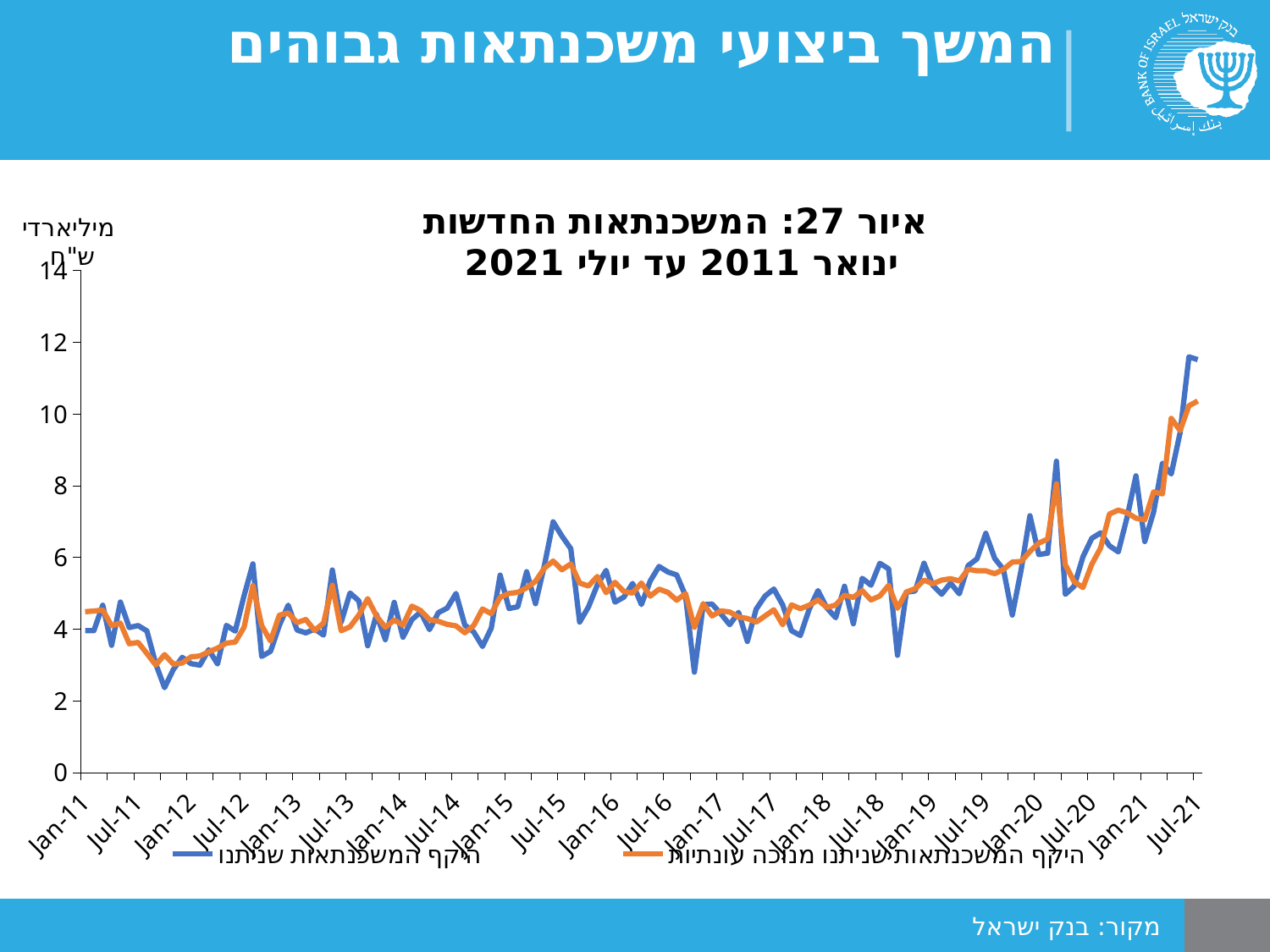
Overall, do the values rise or fall from Jan-11 to Jul-21? Rise Is the value of the orange series (היקף המשכנתאות שניתנו מנוכה עונתיות) at Jul-21 greater or less than 8? greater Is the peak of the blue series around Jul-15 greater or less than 6? greater Which series reaches the highest value anywhere on the chart? היקף המשכנתאות שניתנו (blue) Is the value of the blue series (היקף המשכנתאות שניתנו) at Jul-21 greater or less than 10? greater At Jul-21, which series has the higher value, the blue series or the orange series? The blue series (היקף המשכנתאות שניתנו) What is the title of the chart? איור 27: המשכנתאות החדשות ינואר 2011 עד יולי 2021 What unit is shown on the y axis of the chart? מיליארדי ש"ח What kind of chart is shown on the slide? Line chart How many series does the chart's legend list? 2